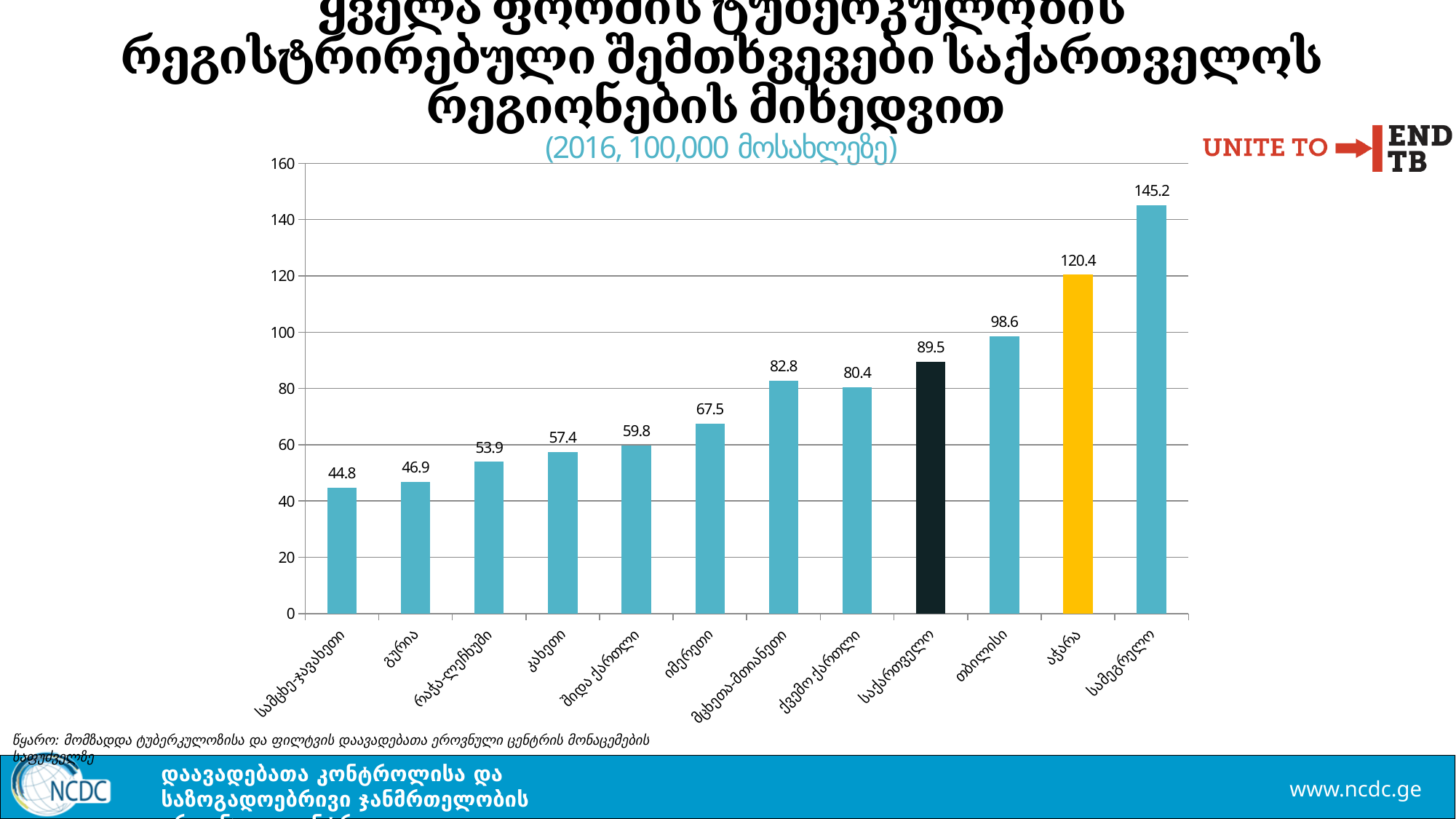
What kind of chart is shown on the slide? bar chart Which is larger, the value for მცხეთა-მთიანეთი or ქვემო ქართლი? მცხეთა-მთიანეთი Which region has the highest value? სამეგრელო What is the difference between the values for სამეგრელო and აჭარა? 24.8 How many bars are shown in the chart? 12 Which region has the lowest value? სამცხე-ჯავახეთი What is the value for საქართველო? 89.5 What is the value for გურია? 46.9 What is the value for სამეგრელო? 145.2 Which bar is coloured yellow? აჭარა What is the value for აჭარა? 120.4 Is the value for თბილისი greater or less than 100? less